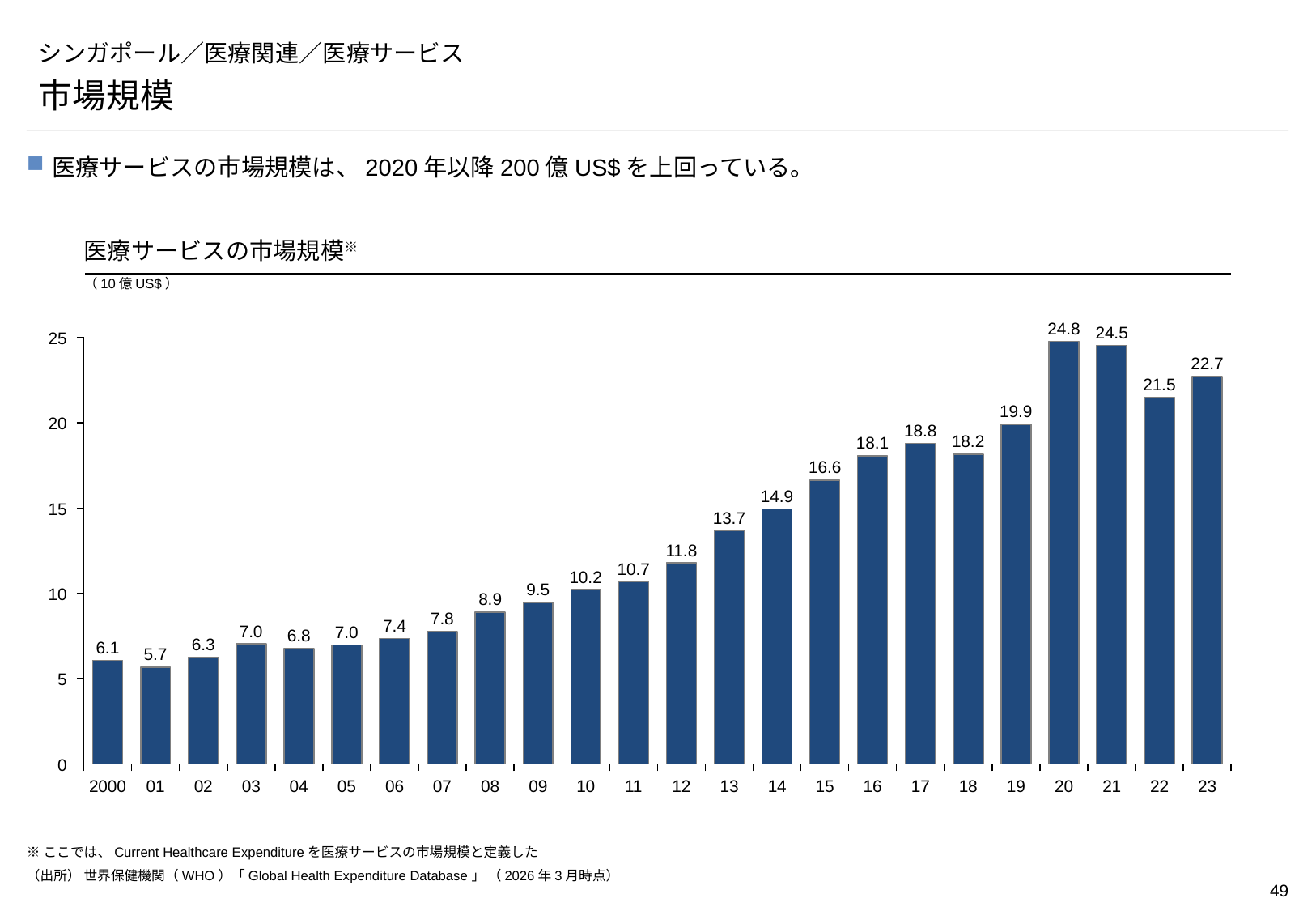
What is the value for 2001 in the chart? 5.7 What kind of chart is shown on the slide? bar chart What is the difference between the values for 2020 and 2021? 0.3 What unit is shown for the values in the chart? 10億US$ Which year has the lowest value in the chart? 2001 What is the value for 2020 in the 医療サービスの市場規模 chart? 24.8 Is the value for 2019 greater or less than 20? less What is the difference between the values for 2023 and 2000? 16.6 Which is larger, the value for 2017 or the value for 2018? 2017 How many years are shown on the x axis of the chart? 24 Which year has the highest value in the chart? 2020 What is the value for 2023 in the chart? 22.7